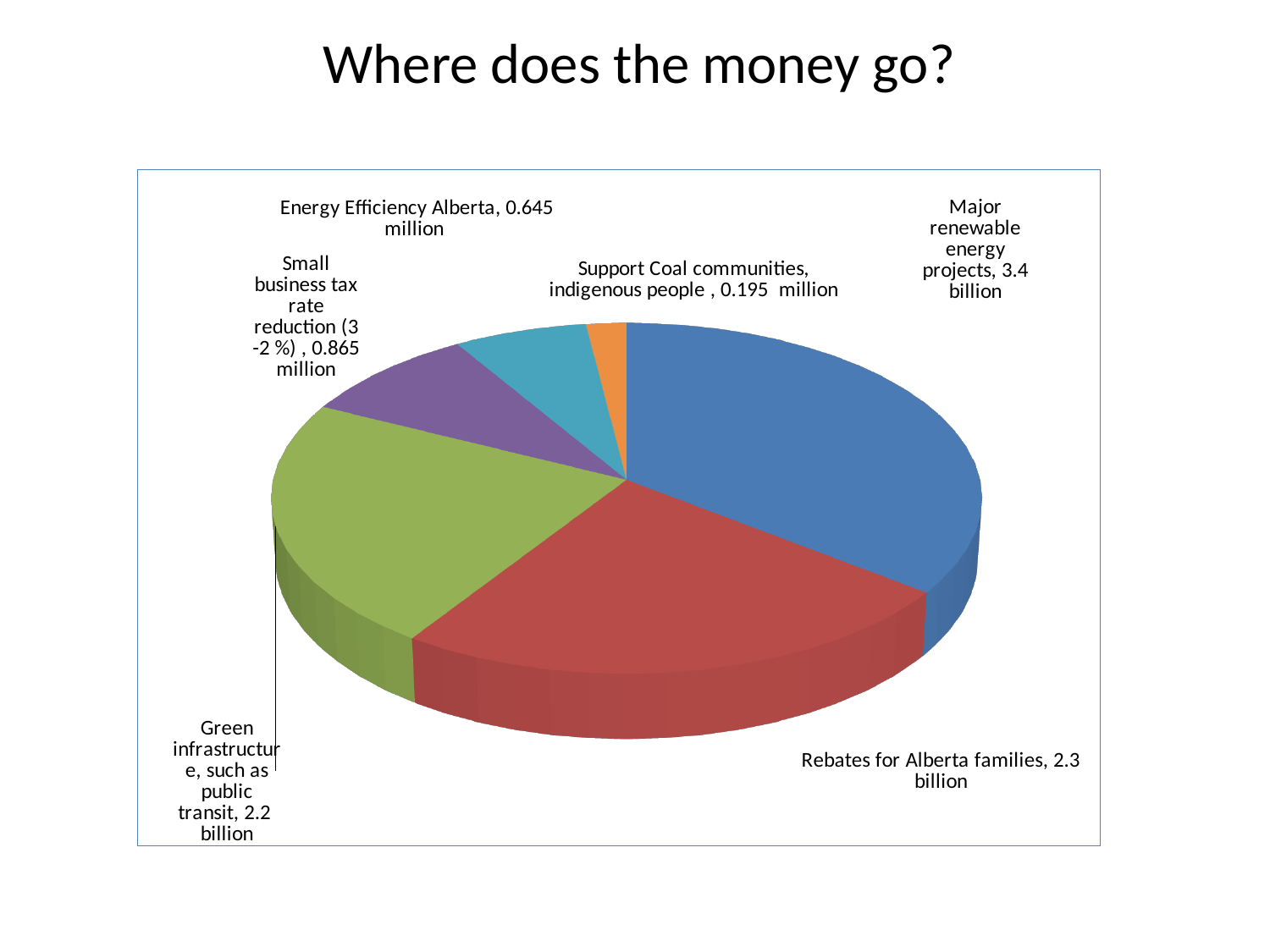
Which category has the smallest slice of the pie? Support Coal communities, indigenous people How many slices does the pie chart have? 6 What is the difference between the values for Major renewable energy projects and Rebates for Alberta families? 1.1 billion What is the title of the slide? Where does the money go? What kind of chart is shown on the slide? Pie chart Which is larger, the value for Small business tax rate reduction or the value for Energy Efficiency Alberta? Small business tax rate reduction What is the value for Support Coal communities, indigenous people? 0.195 million What is the value for Rebates for Alberta families? 2.3 billion What is the value for Green infrastructure, such as public transit? 2.2 billion What is the value for Major renewable energy projects? 3.4 billion Which category has the largest slice of the pie? Major renewable energy projects What is the value for Energy Efficiency Alberta? 0.645 million